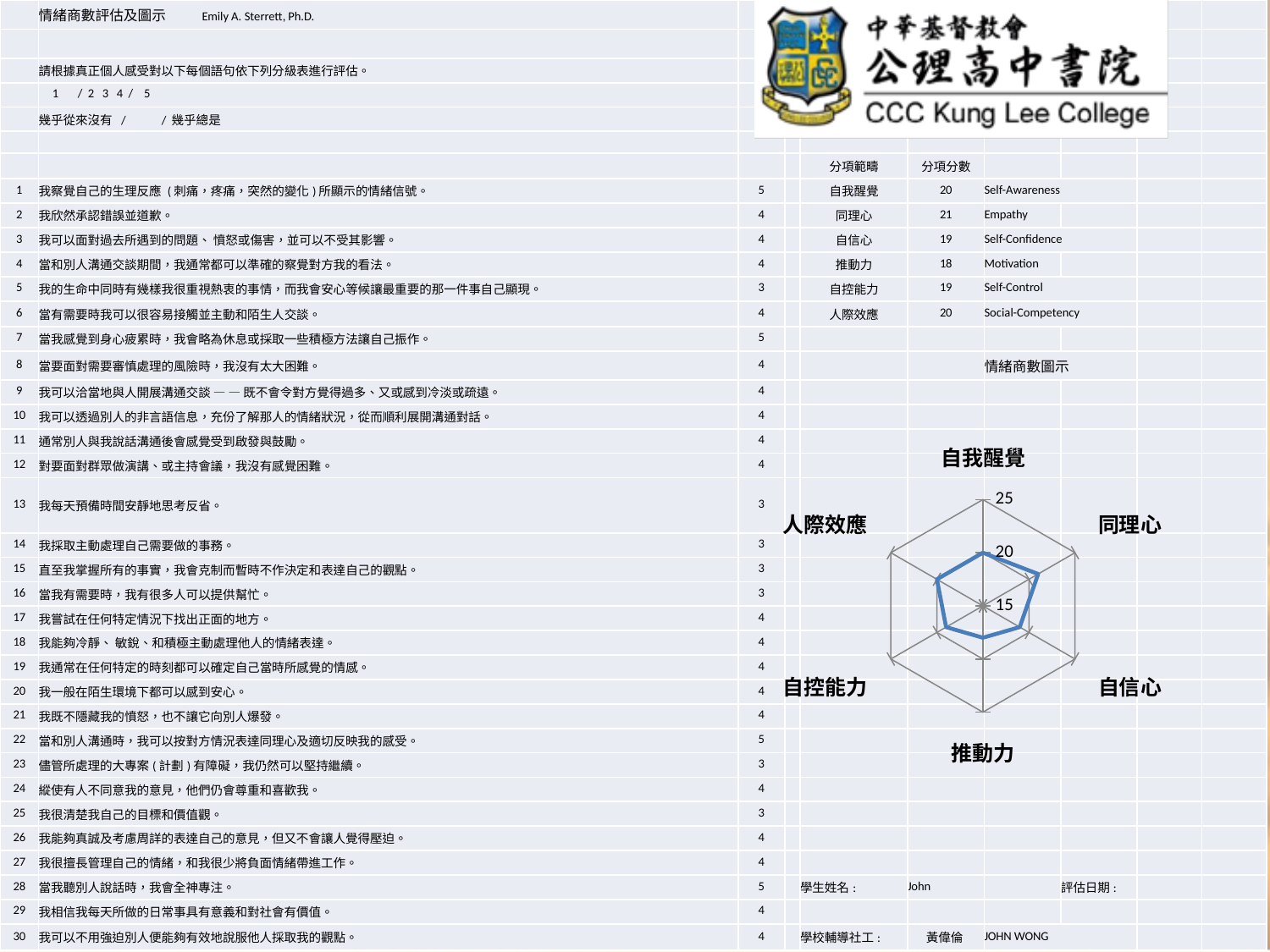
How many categories (axes) does the radar chart have? 6 Is the value for 自我醒覺 greater or less than 25? less What is the title shown above the radar chart? 情緒商數圖示 Is the value for 推動力 greater or less than 15? greater What is the score for 同理心 (Empathy)? 21 What is the score for 推動力 (Motivation)? 18 What is the score for 自我醒覺 (Self-Awareness)? 20 What kind of chart is shown on the slide? radar chart What is the score for 人際效應 (Social-Competency)? 20 Which category has the lowest score? 推動力 Which category has the highest score? 同理心 What is the difference between the scores for 同理心 and 推動力? 3